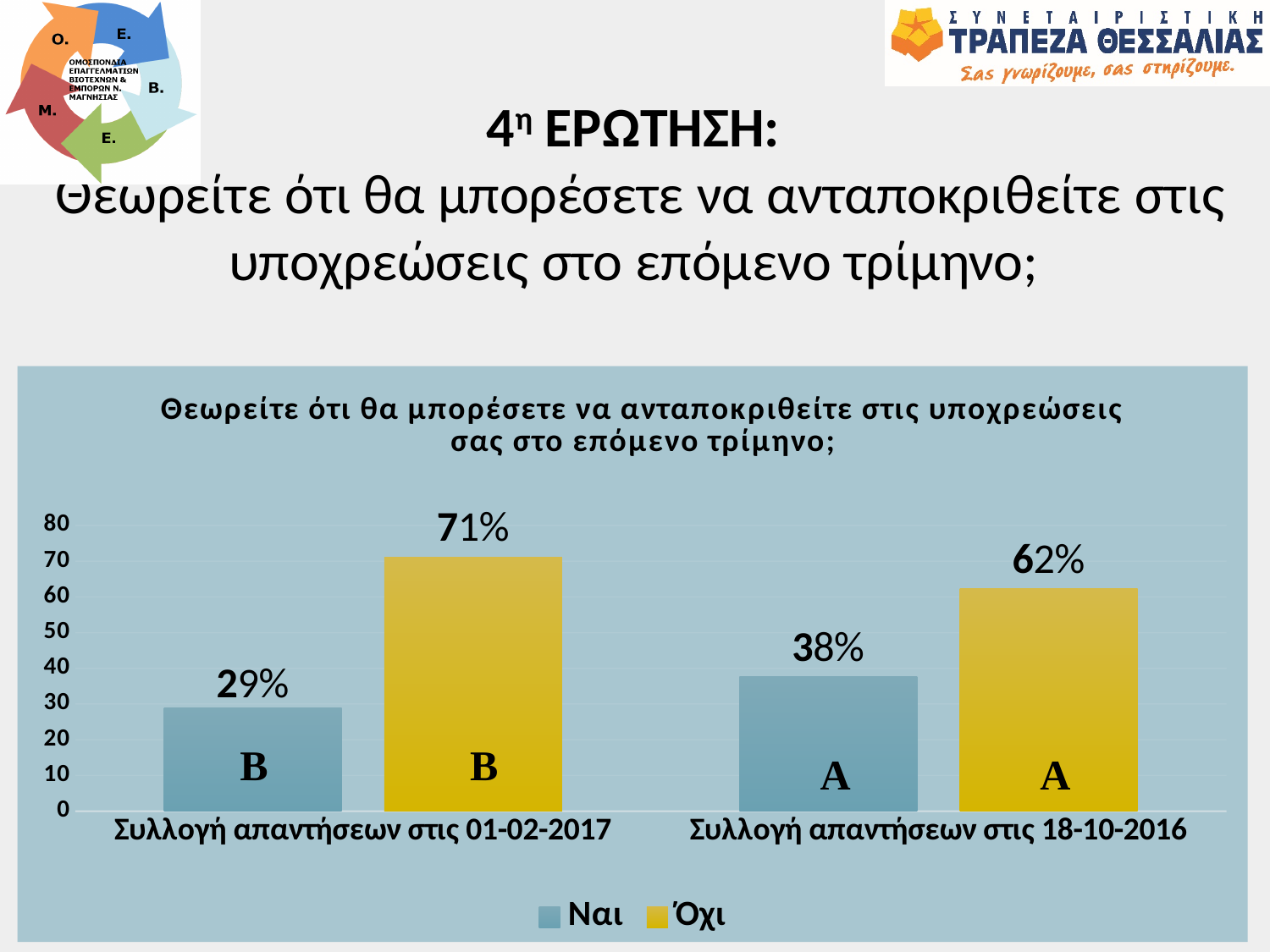
What is the value for Όχι in the 'Συλλογή απαντήσεων στις 01-02-2017' category? 71% What is the value for Όχι in the 'Συλλογή απαντήσεων στις 18-10-2016' category? 62% What is the value for Ναι in the 'Συλλογή απαντήσεων στις 18-10-2016' category? 38% Which bar has the lowest value on the chart? Ναι, Συλλογή απαντήσεων στις 01-02-2017 What kind of chart is shown on the slide? Bar chart What is the value for Ναι in the 'Συλλογή απαντήσεων στις 01-02-2017' category? 29% How many series does the legend list? 2 What is the difference between the Ναι values for 18-10-2016 and 01-02-2017? 9% How many categories are shown on the x axis? 2 Which bar has the highest value on the chart? Όχι, Συλλογή απαντήσεων στις 01-02-2017 Which is larger: the Όχι value for 01-02-2017 or the Όχι value for 18-10-2016? Όχι for 01-02-2017 What is the difference between the Όχι and Ναι values for 'Συλλογή απαντήσεων στις 01-02-2017'? 42%